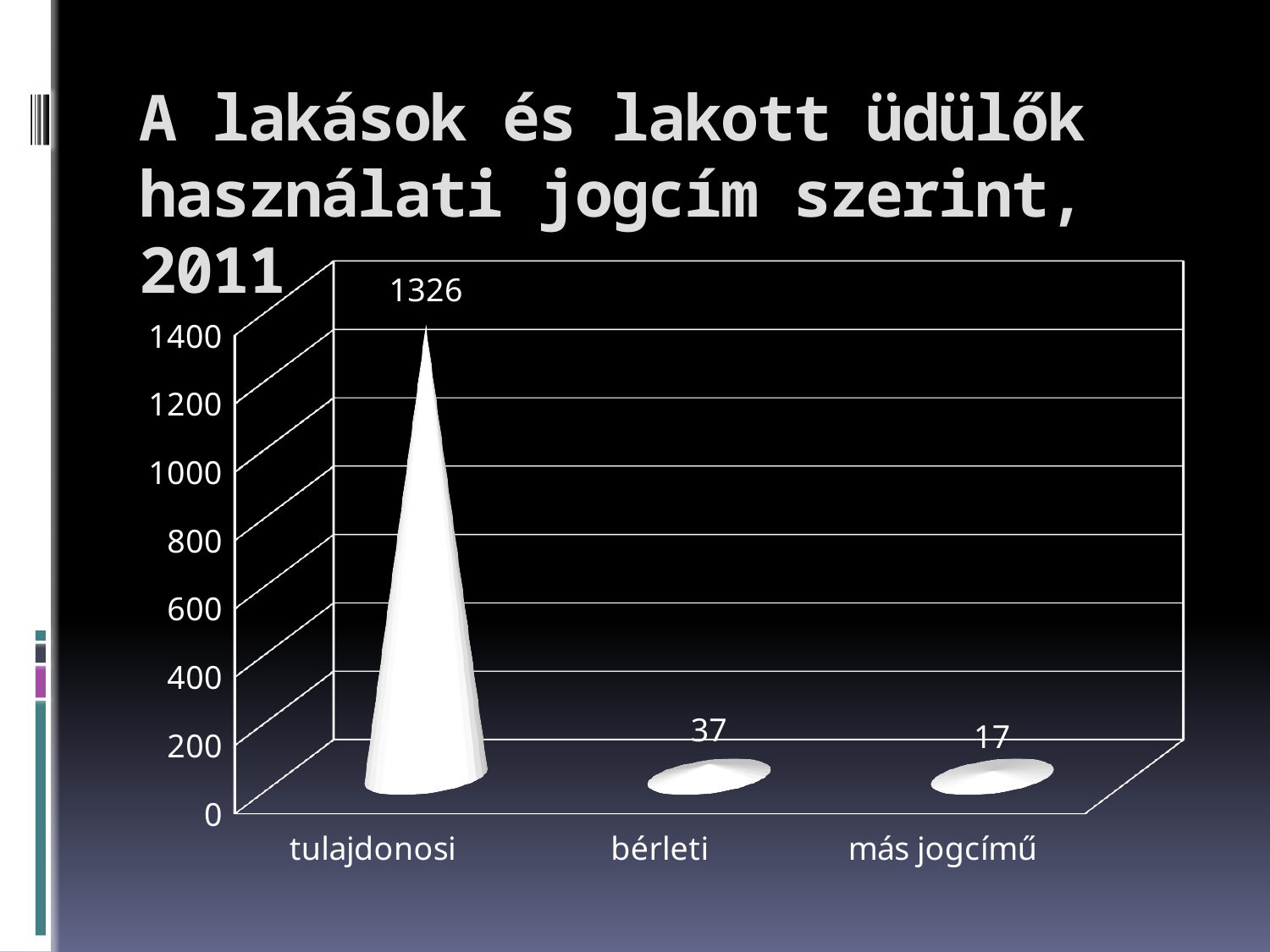
Which is larger, the value for bérleti or the value for más jogcímű? bérleti What is the value for bérleti? 37 What kind of chart is shown on the slide? bar chart What is the value for más jogcímű? 17 What is the title of the slide? A lakások és lakott üdülők használati jogcím szerint, 2011 What is the difference between the values for tulajdonosi and bérleti? 1289 Which category has the lowest value? más jogcímű What is the value for tulajdonosi? 1326 What is the difference between the values for bérleti and más jogcímű? 20 Which category has the highest value? tulajdonosi Is the value for tulajdonosi greater or less than 1200? greater How many categories are shown on the x axis? 3